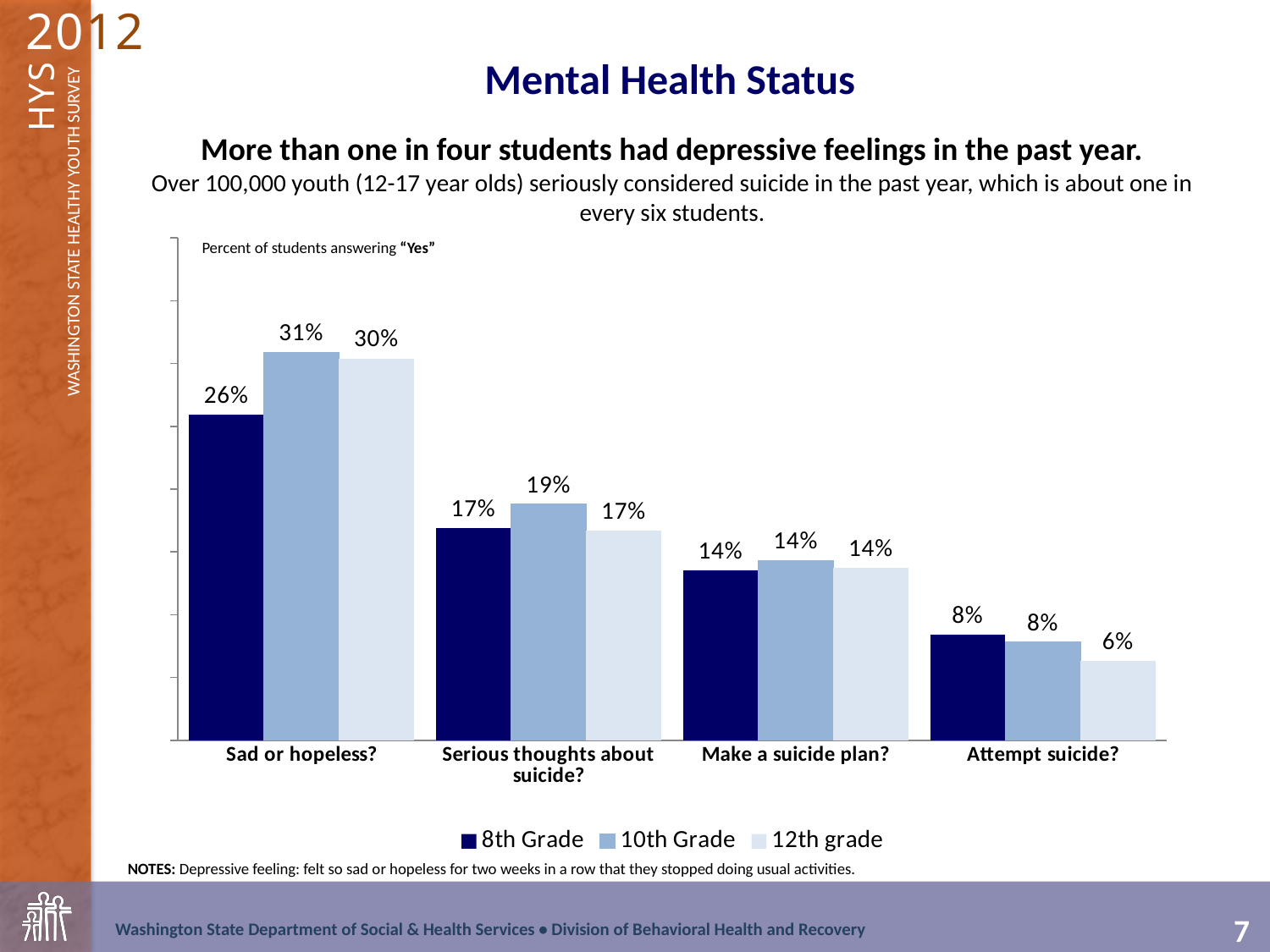
How many series does the legend list? 3 What percentage of 8th Grade students answered "Yes" to "Sad or hopeless?" 26% What kind of chart is shown on the slide? Bar chart Which grade has the highest value for "Sad or hopeless?" 10th Grade Which question category has the lowest values across all grades? Attempt suicide? Which is larger: the 10th Grade value for "Serious thoughts about suicide?" or the 12th grade value for "Serious thoughts about suicide?" 10th Grade How many question categories are shown on the x axis? 4 Do the values for 8th Grade rise or fall from left to right across the categories? Fall What is the difference between the 8th Grade and 12th grade values for "Attempt suicide?" 2% What percentage of 12th grade students answered "Yes" to "Attempt suicide?" 6% What is the difference between the 10th Grade and 8th Grade values for "Sad or hopeless?" 5% What percentage of 10th Grade students answered "Yes" to "Serious thoughts about suicide?" 19%